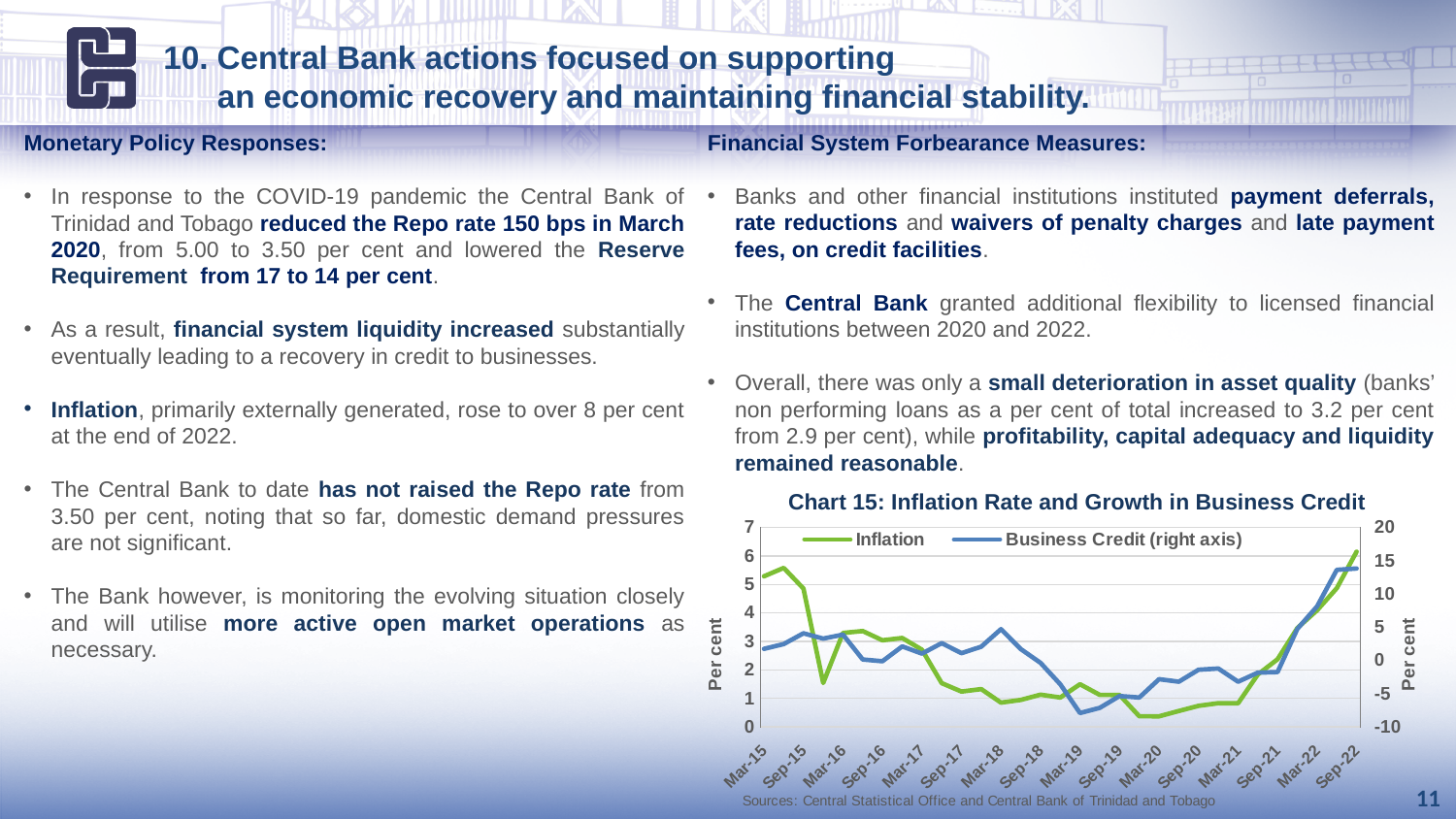
In Chart 15, at which date does the Inflation series reach its highest value? Sep-22 In Chart 15, is the Inflation value at Mar-15 greater or less than 5? greater How many date labels are shown on the x axis of Chart 15? 16 In Chart 15, is the Inflation value at Mar-20 greater or less than 1? less In Chart 15, is the Business Credit value at Sep-22 greater or less than 10? greater What is the title of the chart on the slide? Chart 15: Inflation Rate and Growth in Business Credit How many series does the legend of Chart 15 list? 2 In Chart 15, does the Inflation series rise or fall between Mar-21 and Sep-22? rise What type of chart is Chart 15? Line chart In Chart 15, which series is plotted against the right axis? Business Credit